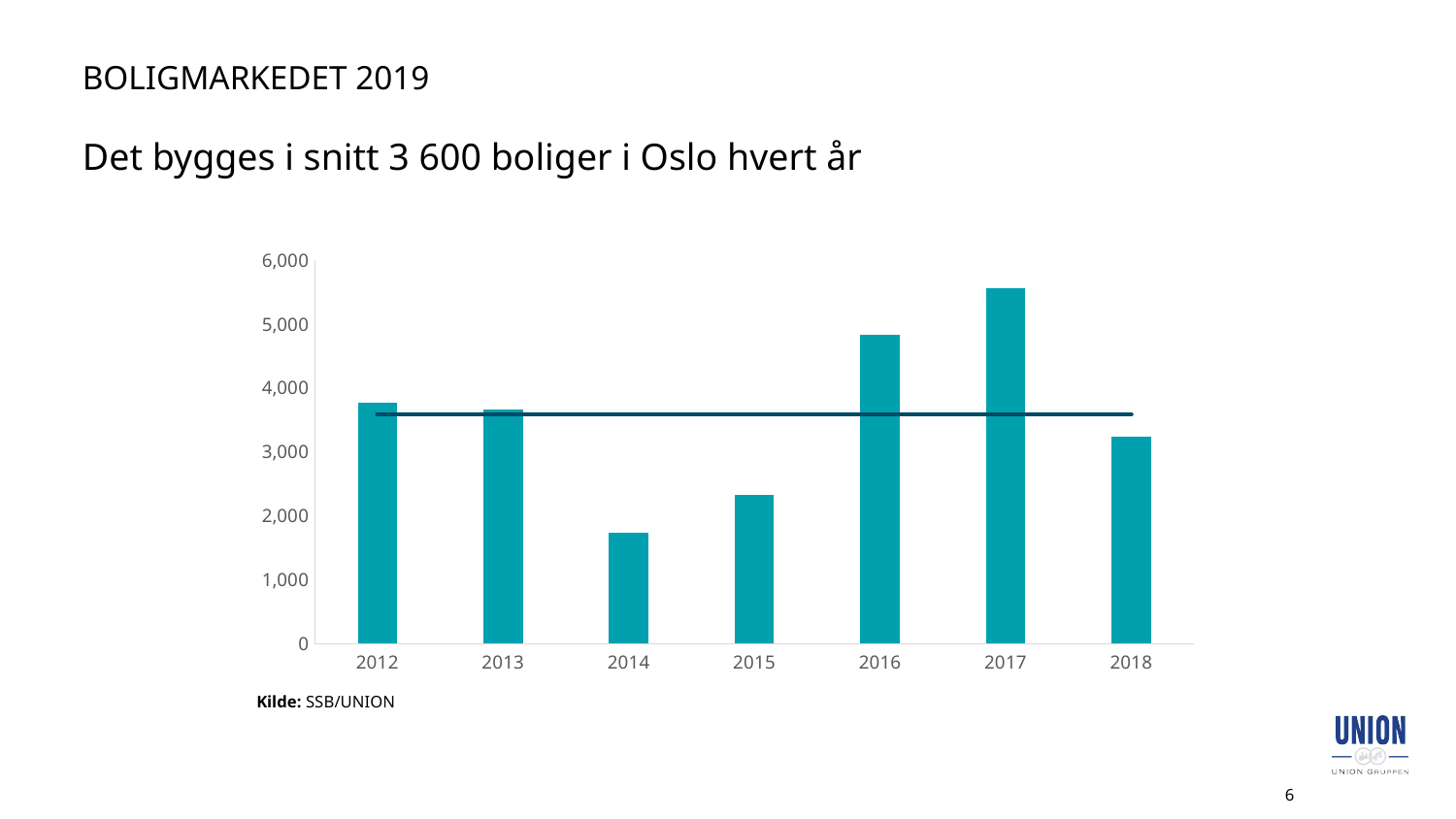
Is the value for 2016 greater or less than 4,000? greater Is the value for 2017 greater or less than 5,000? greater Is the value for 2018 greater or less than 4,000? less What source is cited below the chart? SSB/UNION Which year has the larger value, 2018 or 2014? 2018 What kind of chart is shown on the slide? bar chart Which year has the larger value, 2016 or 2015? 2016 Which year has the lowest bar in the chart? 2014 How many years are shown on the x axis of the chart? 7 Which year has the highest bar in the chart? 2017